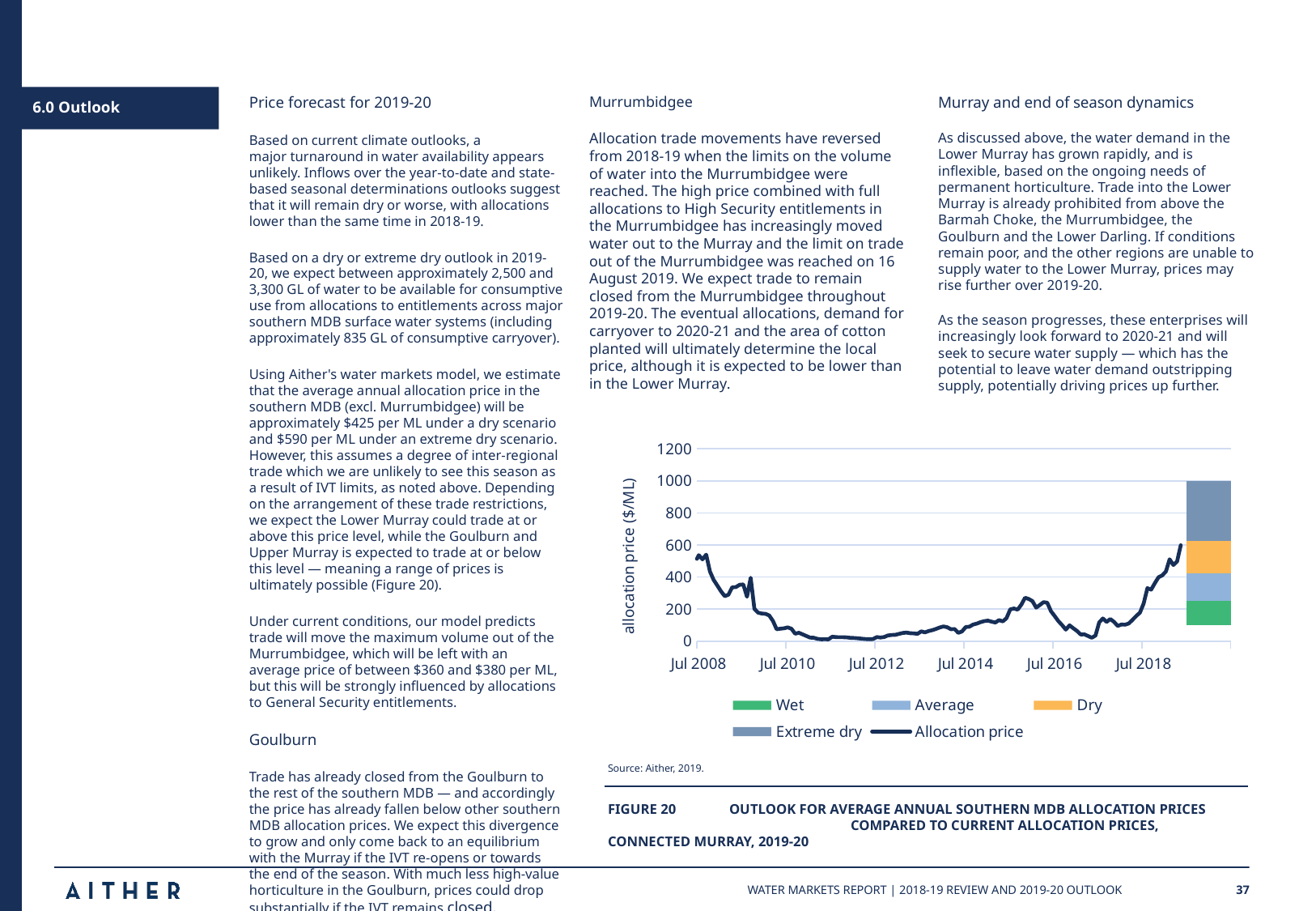
Which scenario band sits lowest on the stacked bar at the right of the chart? Wet Is the allocation price at Jul 2016 greater or less than 400? less Is the allocation price at Jul 2012 greater or less than 200? less Which is larger, the allocation price at Jul 2008 or at Jul 2012? Jul 2008 Which scenario band sits highest on the stacked bar at the right of the chart? Extreme dry How many series does the legend list? 5 Is the allocation price at the end of the line (2019) greater or less than 400? greater Does the allocation price rise or fall between Jul 2017 and 2019? rise What is the y-axis label of the chart? allocation price ($/ML) Does the allocation price rise or fall between Jul 2008 and Jul 2012? fall What are the legend entries on the chart? Wet, Average, Dry, Extreme dry, Allocation price